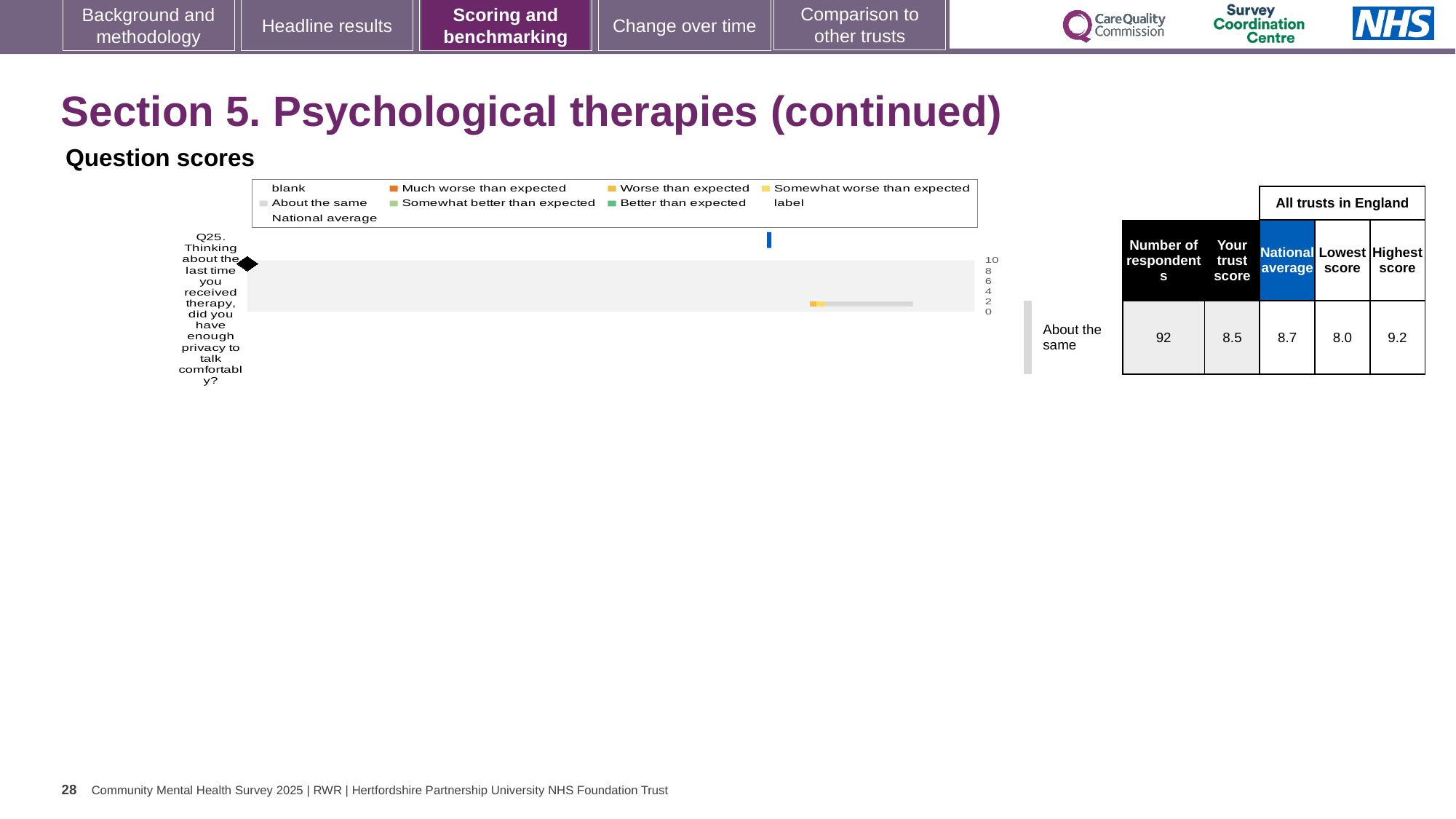
What is the trust score shown for Q25? 8.5 What is the difference between the highest score (9.2) and the lowest score (8.0) shown for Q25? 1.2 What is the national average shown for Q25? 8.7 How many respondents are shown for Q25? 92 What benchmark category is shown for Q25? About the same What kind of chart is shown under 'Question scores'? bar chart Which question number is plotted in the Question scores chart? Q25 What is the highest value shown on the chart's score axis? 10 How many questions (categories) are plotted in the Question scores chart? 1 Which is larger for Q25, the trust score or the national average? national average